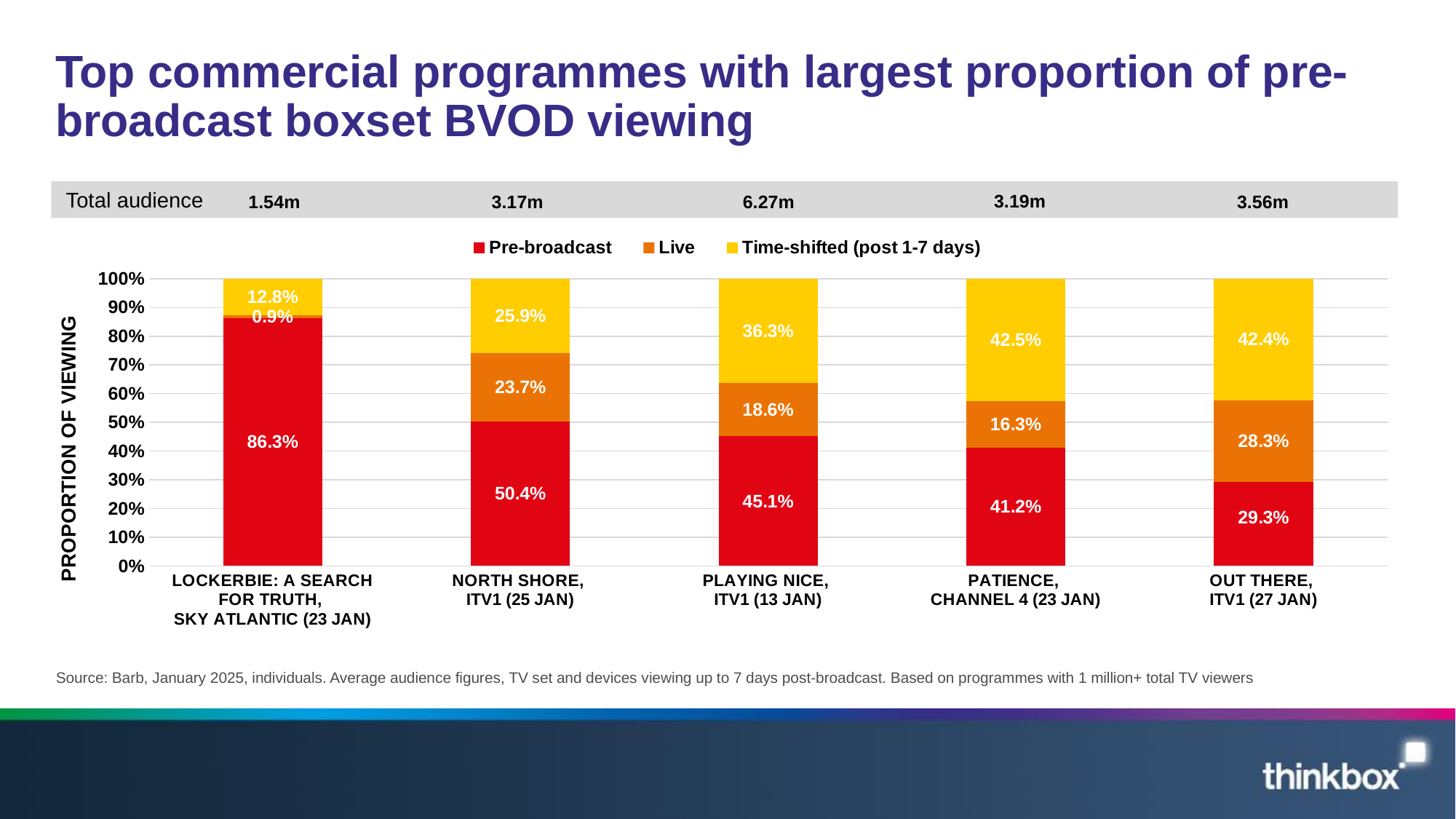
What type of chart is shown on the slide? Stacked bar chart What was the Time-shifted (post 1-7 days) proportion for Out There (ITV1, 27 Jan)? 42.4% How many series does the legend list? 3 Which programme has the lowest pre-broadcast proportion of viewing? Out There, ITV1 (27 Jan) What proportion of viewing for Lockerbie: A Search for Truth (Sky Atlantic, 23 Jan) was pre-broadcast? 86.3% How many programmes are shown in the chart? 5 What was the Live proportion of viewing for North Shore (ITV1, 25 Jan)? 23.7% Which has the larger Live proportion of viewing: Out There or Patience? Out There Does the pre-broadcast proportion rise or fall moving from left to right across the programmes? Fall What colour represents Pre-broadcast viewing in the legend? Red Which programme has the highest pre-broadcast proportion of viewing? Lockerbie: A Search for Truth, Sky Atlantic (23 Jan) How many percentage points higher is the pre-broadcast proportion for North Shore than for Playing Nice? 5.3 percentage points